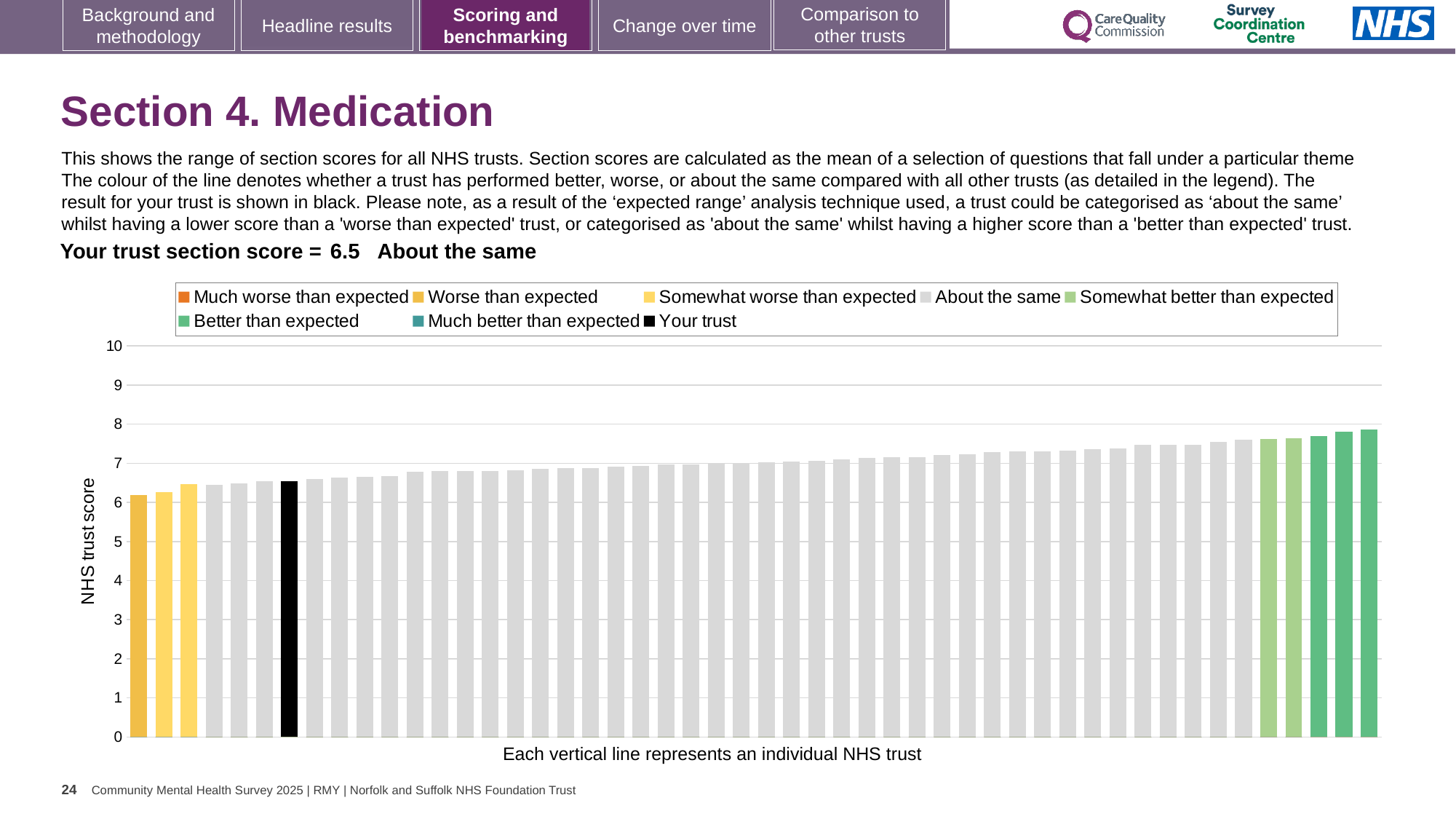
Is the value for your trust's bar greater or less than 6? greater How many entries does the chart legend list? 8 Is the value of the tallest bar greater or less than 8? less Is the value of the shortest bar greater or less than 7? less What kind of chart is shown on the slide? bar chart Do the bar values rise or fall from left to right along the x axis? rise What colour is the bar representing your trust? black What is the label on the vertical axis of the chart? NHS trust score What is your trust's section score for Section 4. Medication? 6.5 How is your trust categorised for Section 4. Medication? About the same Which is larger, the leftmost bar or your trust's black bar? your trust's black bar